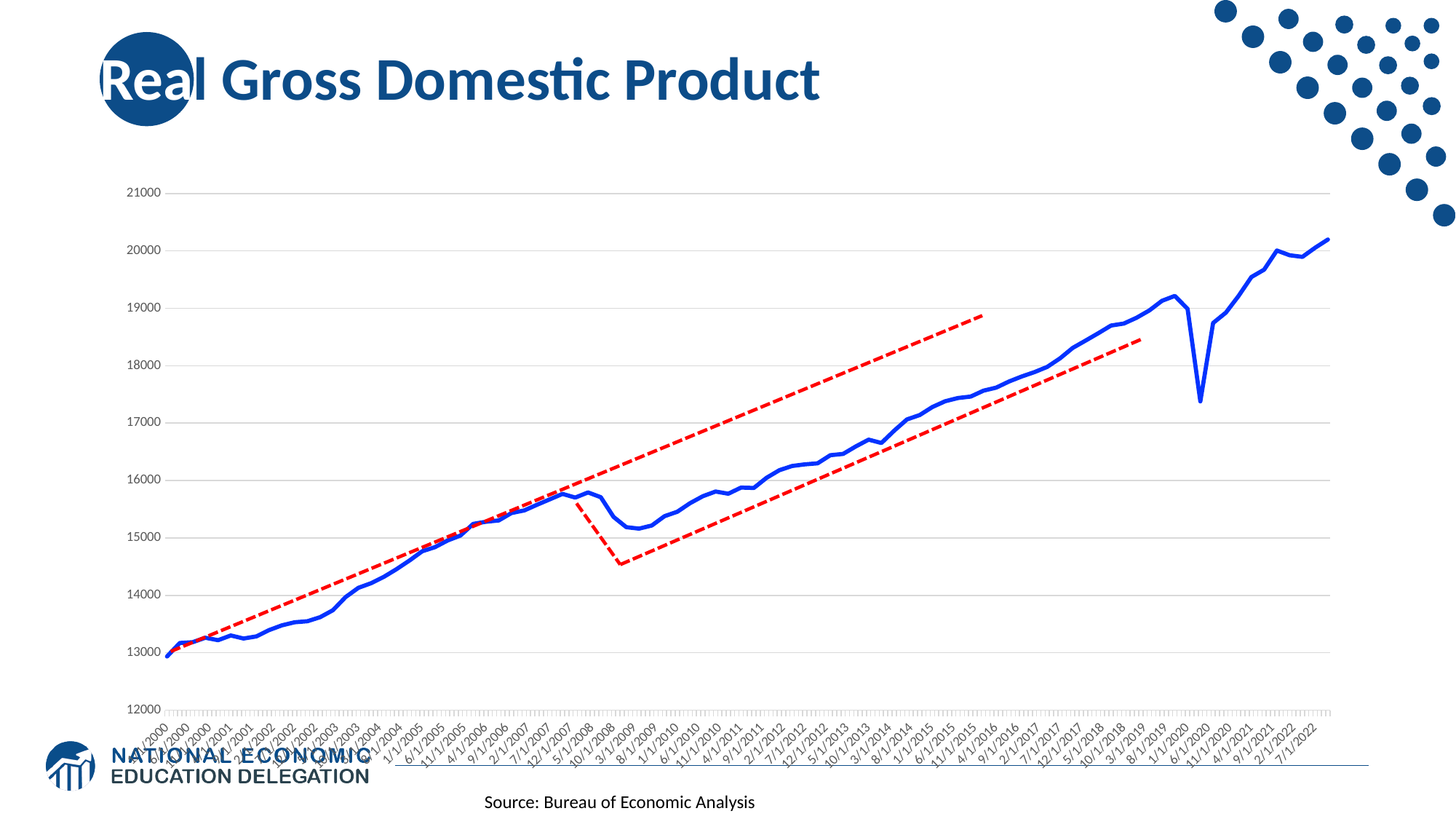
At which date on the x axis does the line have its lowest value? 1/1/2000 What kind of chart is shown on the slide? Line chart Is the value for 3/1/2009 greater or less than 16000? less Is the value for 7/1/2022 greater or less than 19000? greater What source is cited for the chart's data? Bureau of Economic Analysis What is the title of the chart? Real Gross Domestic Product Which is larger, the value for 1/1/2000 or the value for 7/1/2022? 7/1/2022 Is the value for 1/1/2000 greater or less than 14000? less Overall, do the values rise or fall from 2000 to 2022 along the x axis? Rise Which is larger, the value for 3/1/2009 or the value for 6/1/2020? 6/1/2020